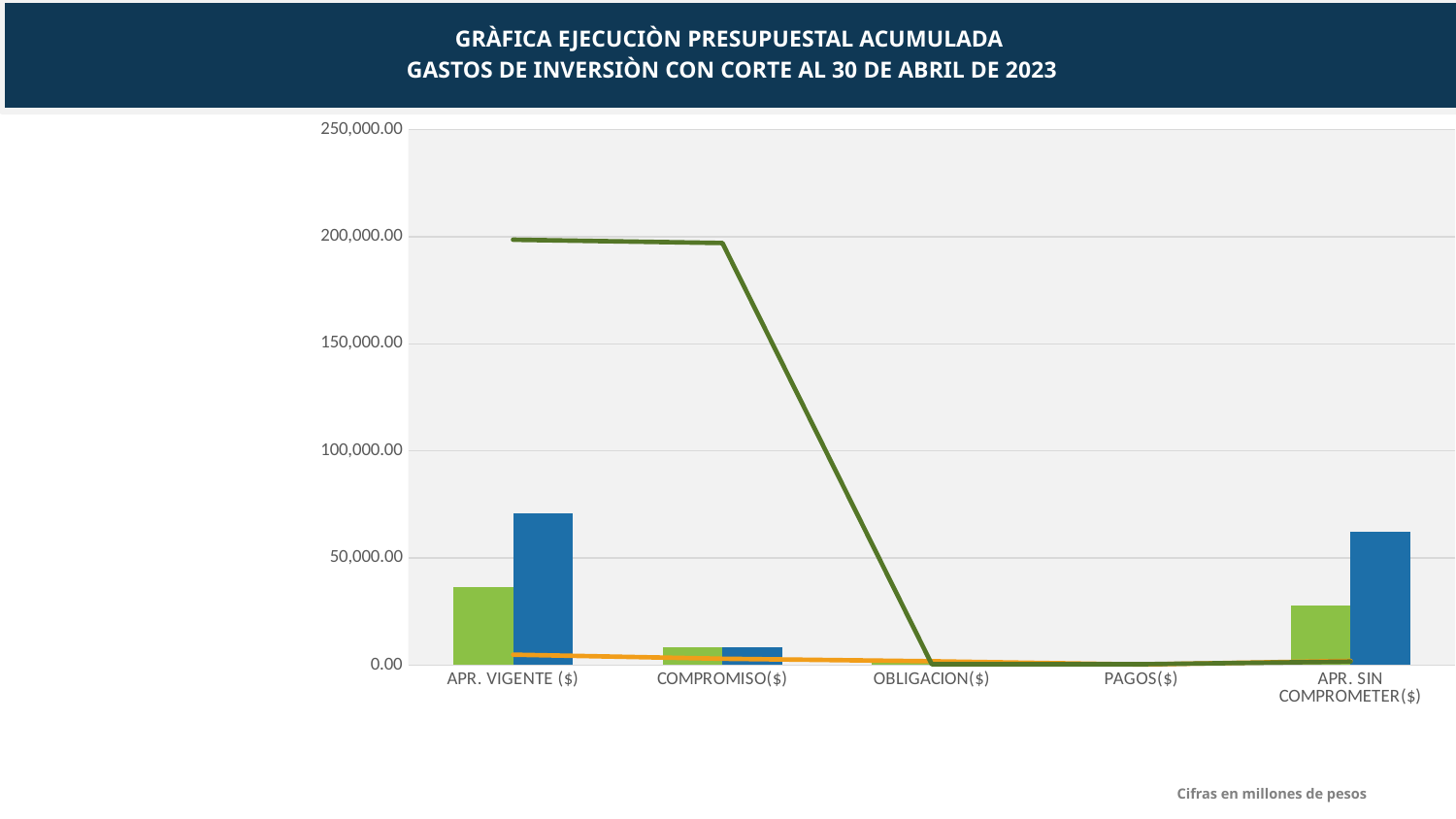
Is the dark green line value for OBLIGACION($) greater or less than 50,000.00? less According to the note below the chart, in what units are the figures expressed? Millones de pesos Is the dark green line value for APR. VIGENTE ($) greater or less than 150,000.00? greater What kind of chart is shown on the slide? A combination chart with bars and lines Is the blue bar for APR. SIN COMPROMETER($) greater or less than 50,000.00? greater Which is larger, the blue bar for APR. VIGENTE ($) or the blue bar for APR. SIN COMPROMETER($)? APR. VIGENTE ($) Does the dark green line rise or fall between COMPROMISO($) and OBLIGACION($)? It falls How many categories are shown on the x axis of the chart? 5 Which category has the tallest blue bar? APR. VIGENTE ($) What is the title of the chart on the slide? GRÀFICA EJECUCIÒN PRESUPUESTAL ACUMULADA GASTOS DE INVERSIÒN CON CORTE AL 30 DE ABRIL DE 2023